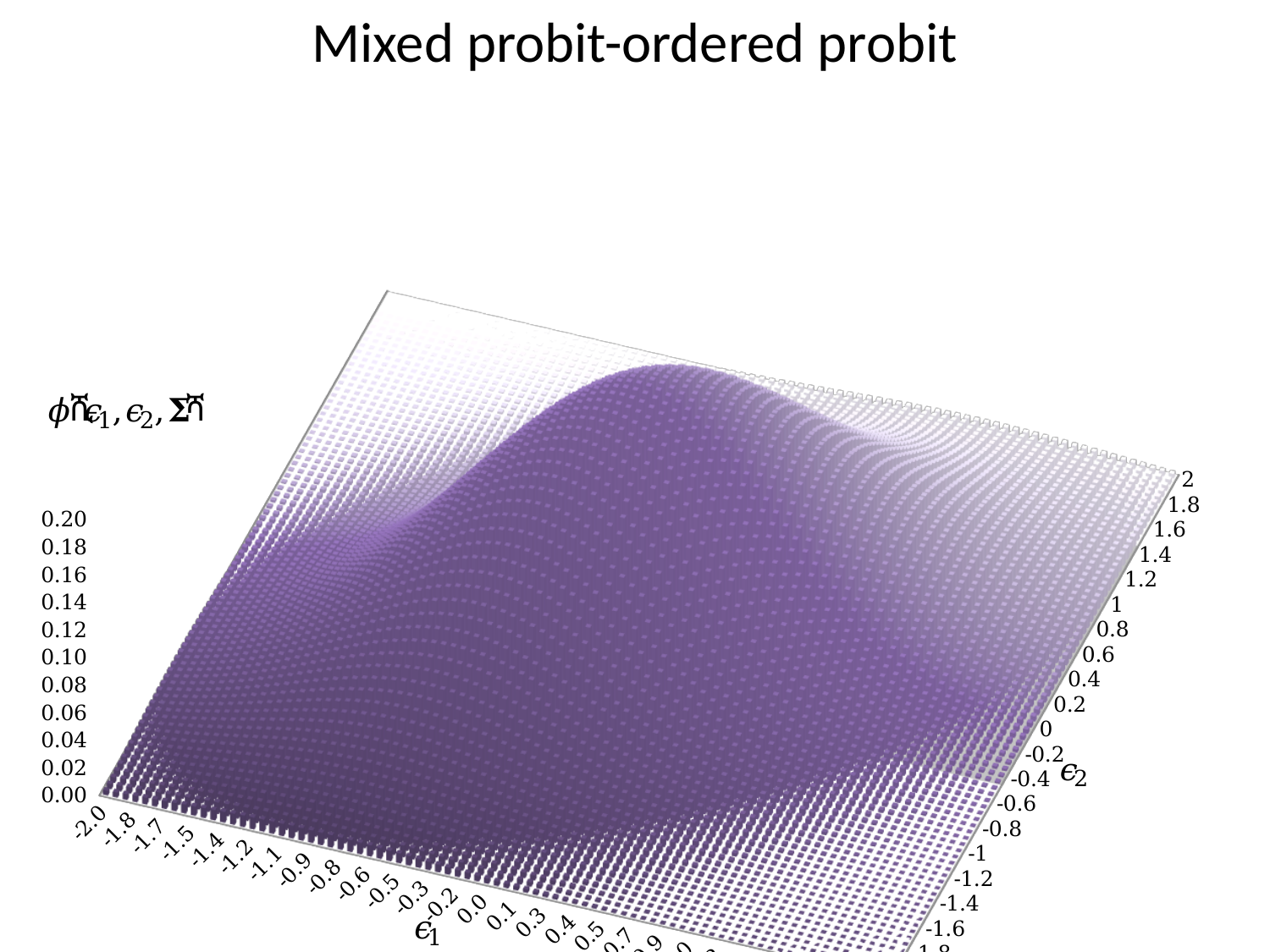
Is the peak height of the surface greater or less than 0.02? greater What is the title of the chart? Mixed probit-ordered probit What is the label of the horizontal axis running along the front of the chart? ε1 What kind of chart is shown on the slide? 3D surface chart